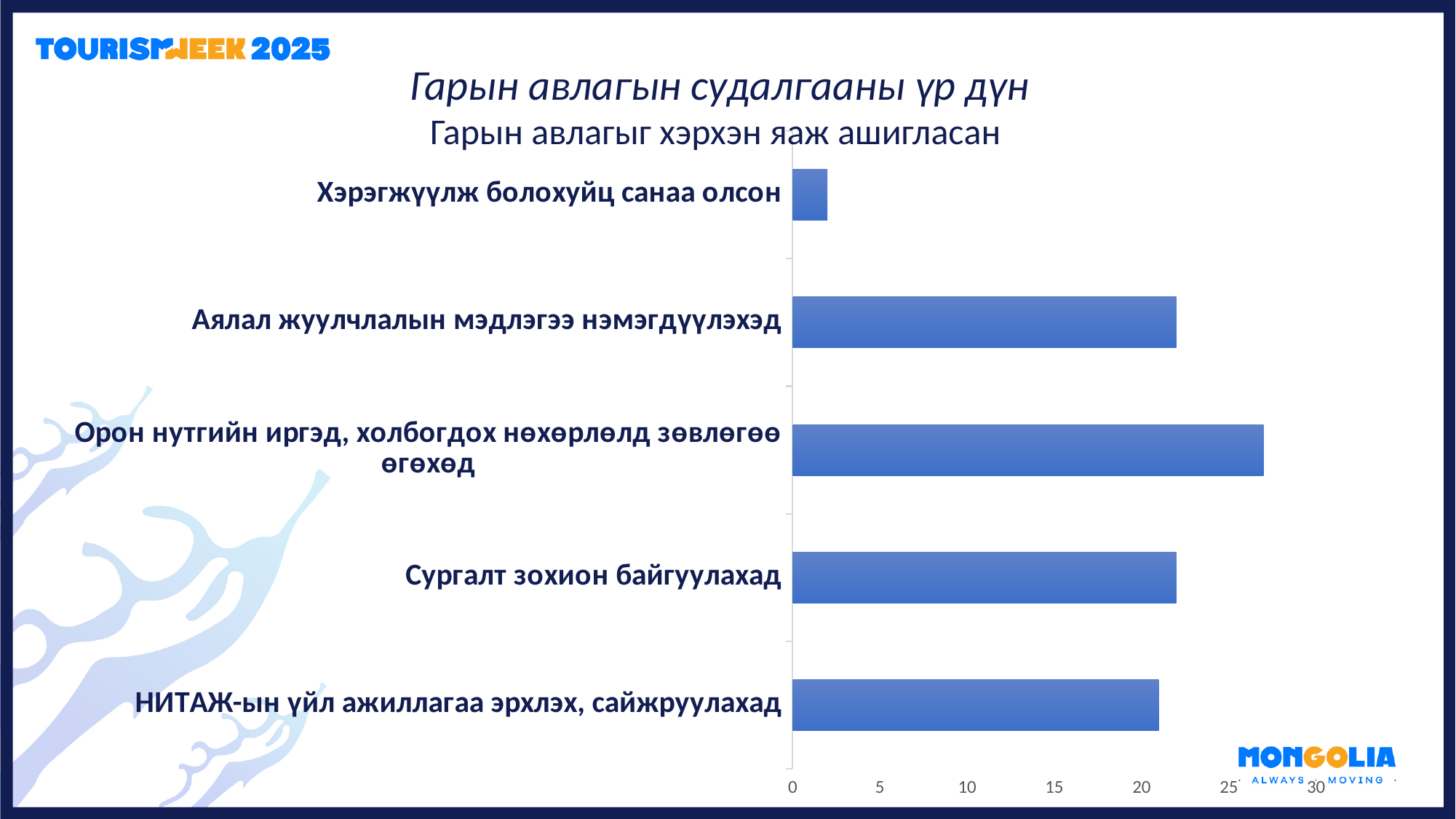
How many categories does the chart show? 5 Which is larger: the value for "Хэрэгжүүлж болохуйц санаа олсон" or for "НИТАЖ-ын үйл ажиллагаа эрхлэх, сайжруулахад"? НИТАЖ-ын үйл ажиллагаа эрхлэх, сайжруулахад What kind of chart is shown on the slide? Bar chart Is the value for "Сургалт зохион байгуулахад" greater or less than 25? less What is the title of the chart? Гарын авлагыг хэрхэн яаж ашигласан Is the value for "НИТАЖ-ын үйл ажиллагаа эрхлэх, сайжруулахад" greater or less than 25? less Which category has the highest value? Орон нутгийн иргэд, холбогдох нөхөрлөлд зөвлөгөө өгөхөд Which category has the lowest value? Хэрэгжүүлж болохуйц санаа олсон Is the value for "Орон нутгийн иргэд, холбогдох нөхөрлөлд зөвлөгөө өгөхөд" greater or less than 25? greater Which is larger: the value for "Орон нутгийн иргэд, холбогдох нөхөрлөлд зөвлөгөө өгөхөд" or for "Сургалт зохион байгуулахад"? Орон нутгийн иргэд, холбогдох нөхөрлөлд зөвлөгөө өгөхөд